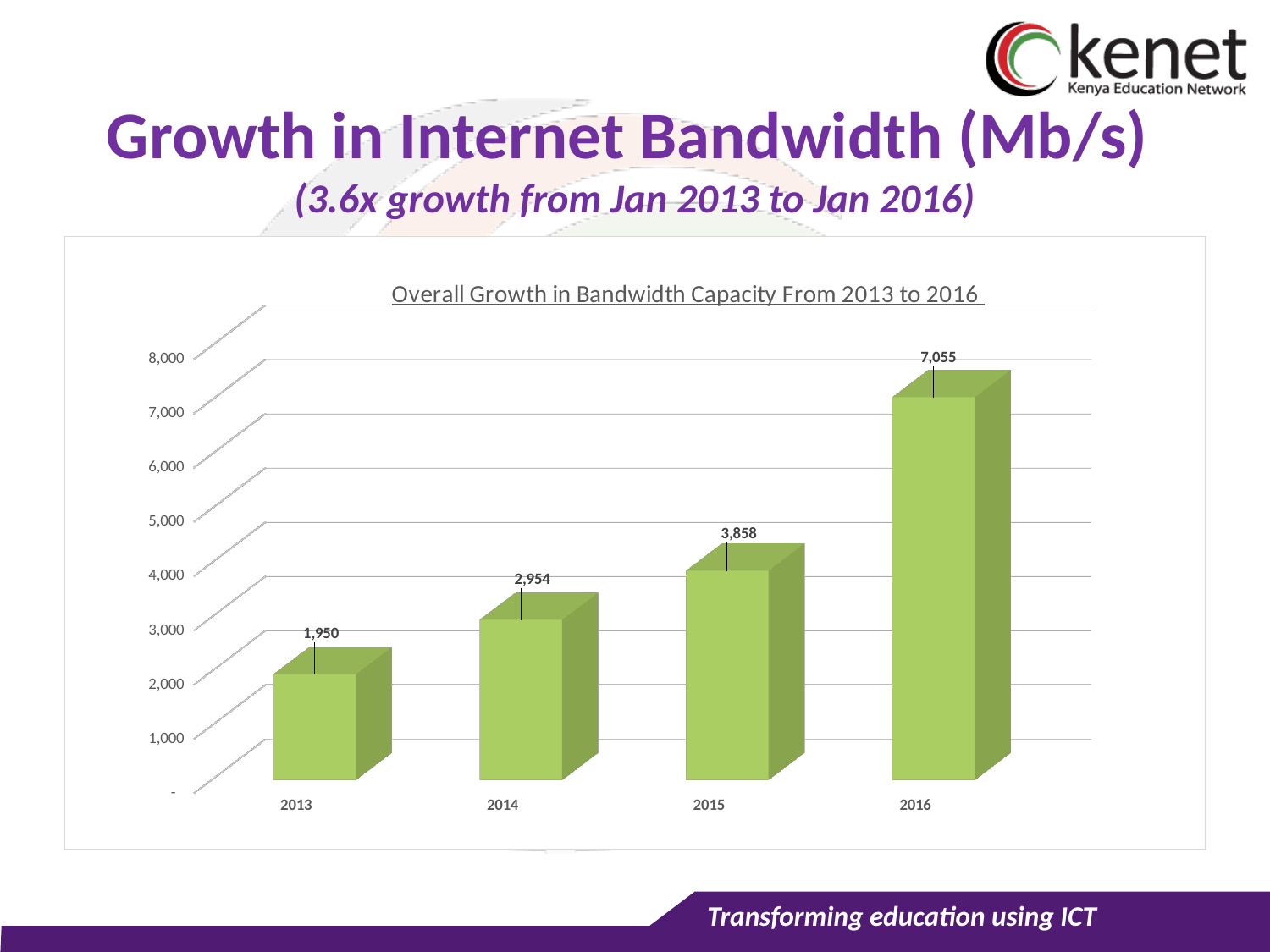
What is the bandwidth capacity value shown for 2016? 7,055 Which year has the lowest bandwidth capacity? 2013 Which year has the highest bandwidth capacity? 2016 What is the difference between the 2016 and 2015 values? 3,197 Which is larger, the value for 2014 or the value for 2015? 2015 Is the value for 2016 greater or less than 6,000? greater How many years are shown on the x axis? 4 Do the values rise or fall from 2013 to 2016? rise What is the difference between the 2014 and 2013 values? 1,004 What is the bandwidth capacity value shown for 2013? 1,950 What is the bandwidth capacity value shown for 2015? 3,858 What kind of chart is shown on the slide? bar chart